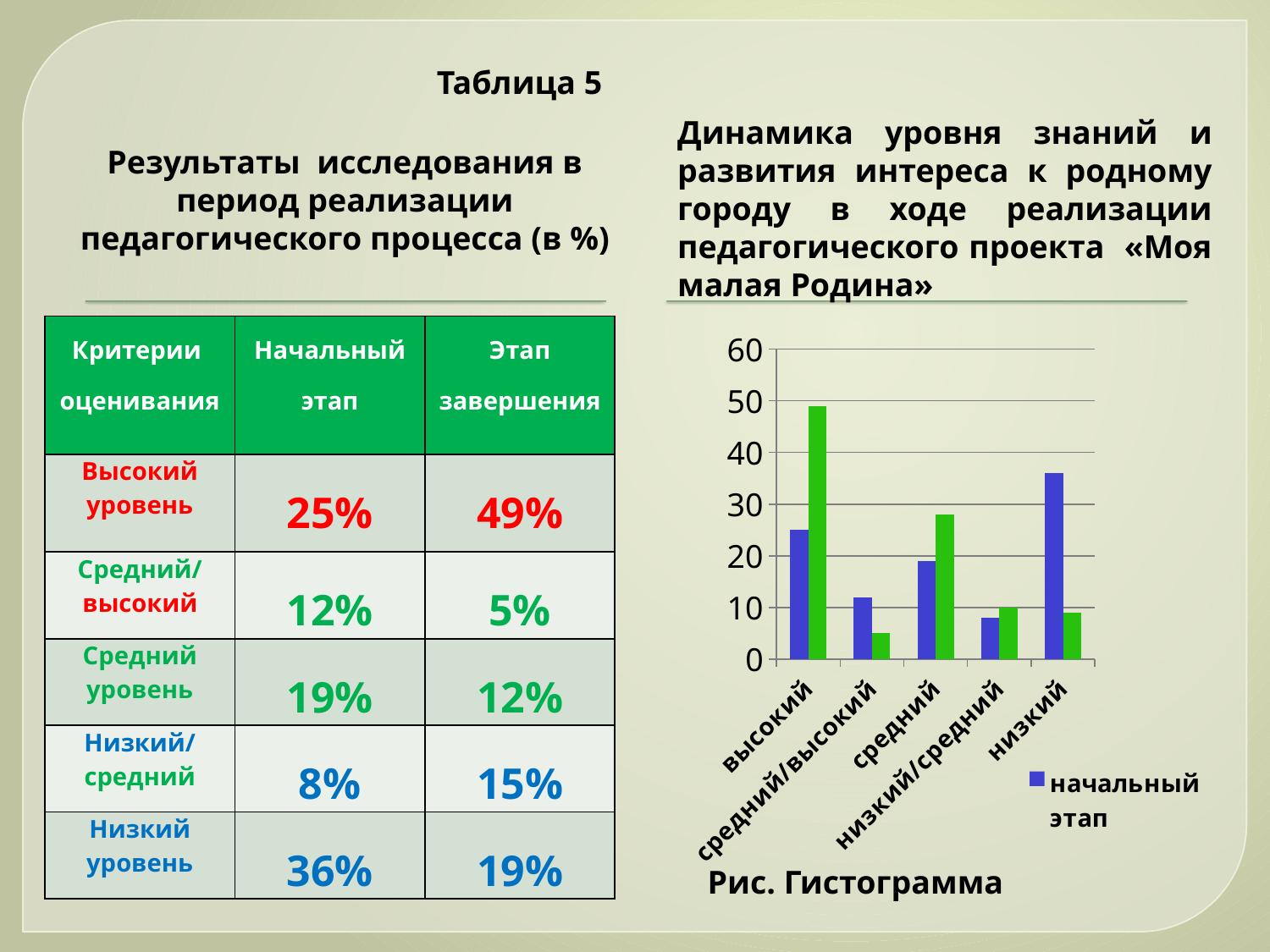
In the bar chart, is the blue bar for низкий greater or less than 30? greater In the bar chart, is the green bar for средний/высокий greater or less than 10? less In the bar chart, is the green bar for средний greater or less than 20? greater In the bar chart, which category has the tallest blue bar? низкий What kind of chart is shown on the right side of the slide? bar chart What colour is the series labelled 'начальный этап' in the bar chart legend? blue In the bar chart, which category has the shortest green bar? средний/высокий In the bar chart, for the category высокий, is the green bar or the blue bar taller? green bar How many categories are shown on the x axis of the bar chart? 5 In the bar chart, which category has the tallest green bar? высокий In the bar chart, for the category низкий, is the blue bar or the green bar taller? blue bar